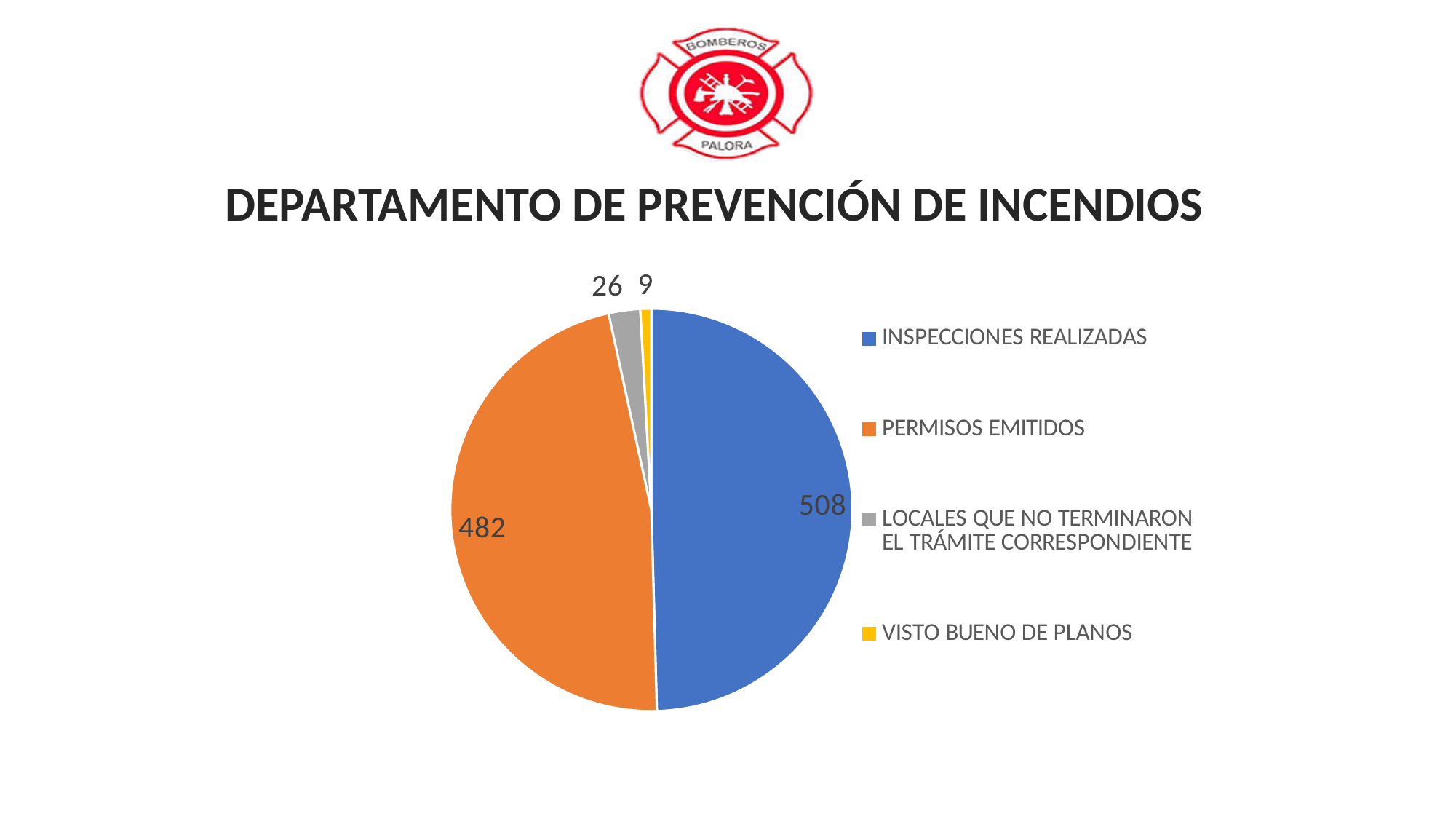
What is the value for PERMISOS EMITIDOS? 482 Which is larger, the value for PERMISOS EMITIDOS or the value for LOCALES QUE NO TERMINARON EL TRÁMITE CORRESPONDIENTE? PERMISOS EMITIDOS How many categories does the pie chart have? 4 What colour is the slice for PERMISOS EMITIDOS? orange What kind of chart is shown on the slide? pie chart What is the value for LOCALES QUE NO TERMINARON EL TRÁMITE CORRESPONDIENTE? 26 What is the difference between the values for INSPECCIONES REALIZADAS and PERMISOS EMITIDOS? 26 What is the difference between the values for LOCALES QUE NO TERMINARON EL TRÁMITE CORRESPONDIENTE and VISTO BUENO DE PLANOS? 17 Which category has the smallest slice of the pie? VISTO BUENO DE PLANOS Which category has the largest slice of the pie? INSPECCIONES REALIZADAS What is the value for VISTO BUENO DE PLANOS? 9 What is the value for INSPECCIONES REALIZADAS? 508